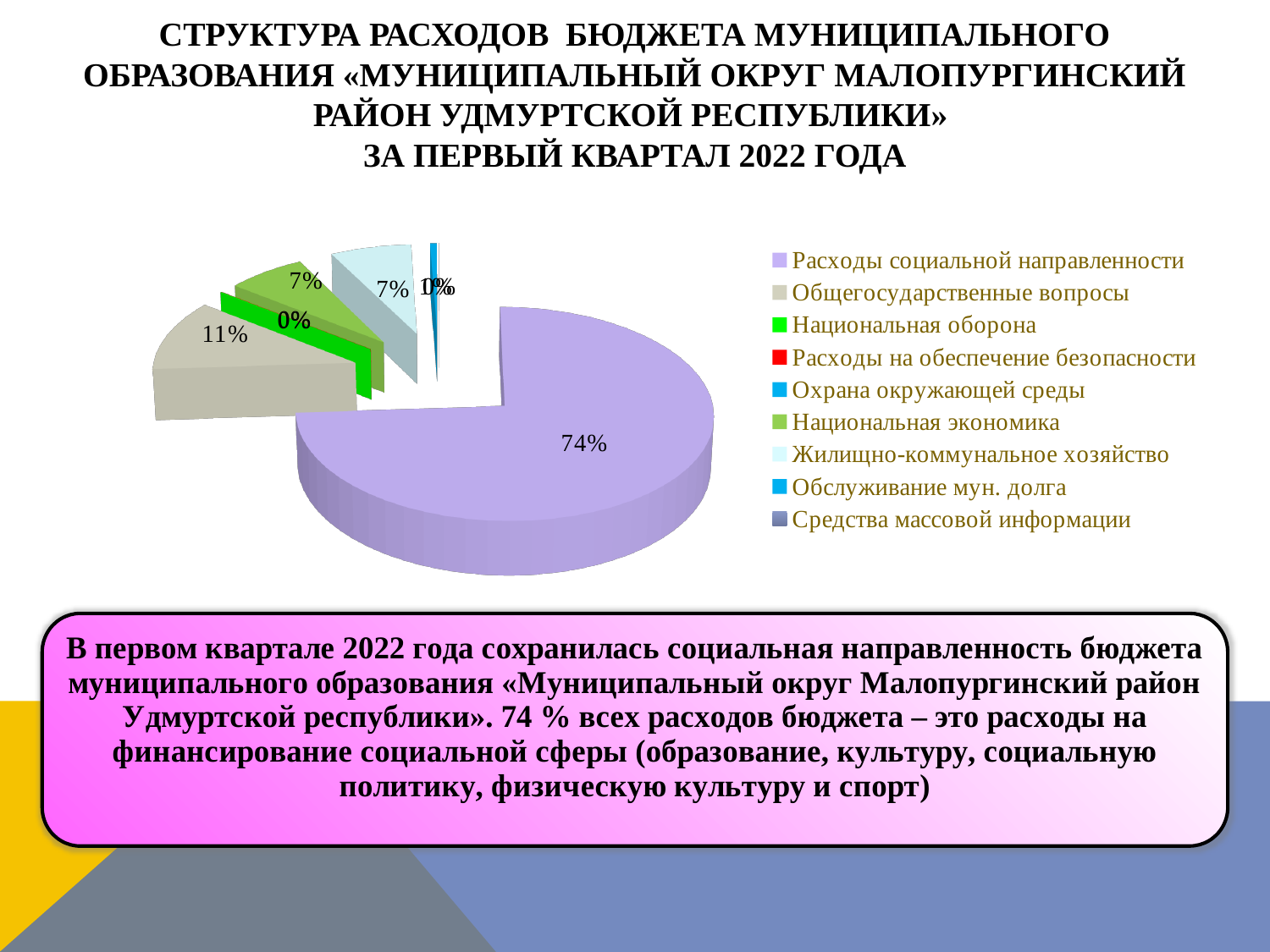
What is the value shown for Национальная экономика? 7% What is the difference in percentage points between Расходы социальной направленности and Общегосударственные вопросы? 63 percentage points Which is larger: Расходы социальной направленности or Общегосударственные вопросы? Расходы социальной направленности Which category is listed first in the legend? Расходы социальной направленности How many entries does the legend list? 9 Which category has the largest slice of the pie? Расходы социальной направленности What is the value shown for Национальная оборона? 0% What colour is the slice for Расходы социальной направленности? Lavender (light purple) What share of the pie does Расходы социальной направленности account for? 74% What kind of chart is shown on the slide? Pie chart What is the value shown for Общегосударственные вопросы? 11% What is the value shown for Жилищно-коммунальное хозяйство? 7%